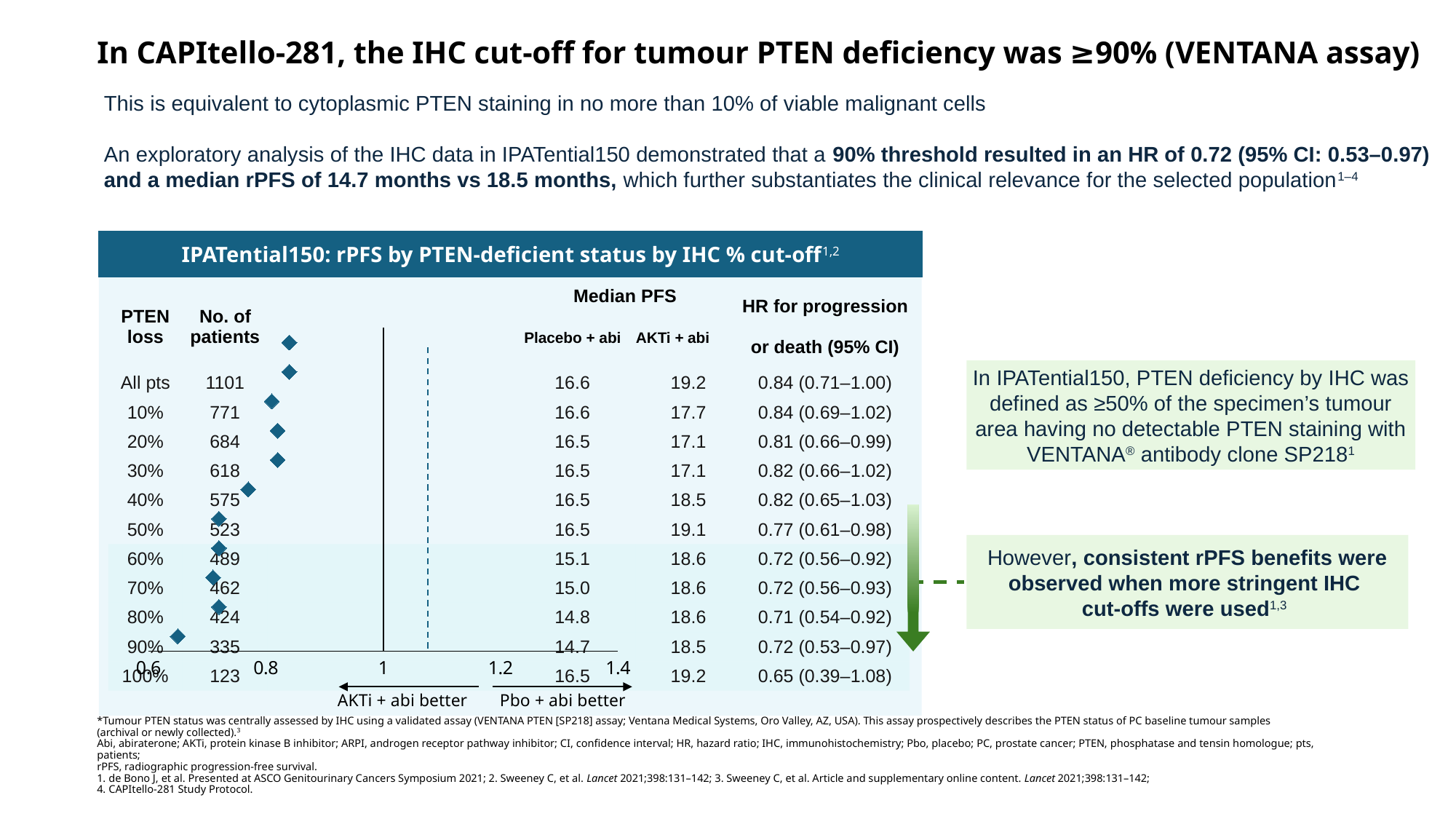
What kind of chart is used to display the hazard ratios? Forest plot As the PTEN loss cut-off increases from 10% to 100%, does the number of patients rise or fall? fall At the 90% cut-off, what is the difference in median PFS between AKTi + abi and Placebo + abi? 3.8 What does the label under the left-pointing arrow on the x axis say? AKTi + abi better Is the HR point estimate for the 100% cut-off greater or less than 0.8? less Which PTEN loss row has the largest number of patients? All pts How many PTEN loss rows (including All pts) are shown in the plot? 11 Which PTEN loss cut-off has the lowest HR point estimate? 100% How many patients are in the 50% PTEN loss cut-off group? 523 What is the median PFS for AKTi + abi at the 40% PTEN loss cut-off? 18.5 What is the HR for progression or death (95% CI) at the 90% PTEN loss cut-off? 0.72 (0.53–0.97) Which has the larger HR point estimate: the 20% cut-off or the 60% cut-off? 20%